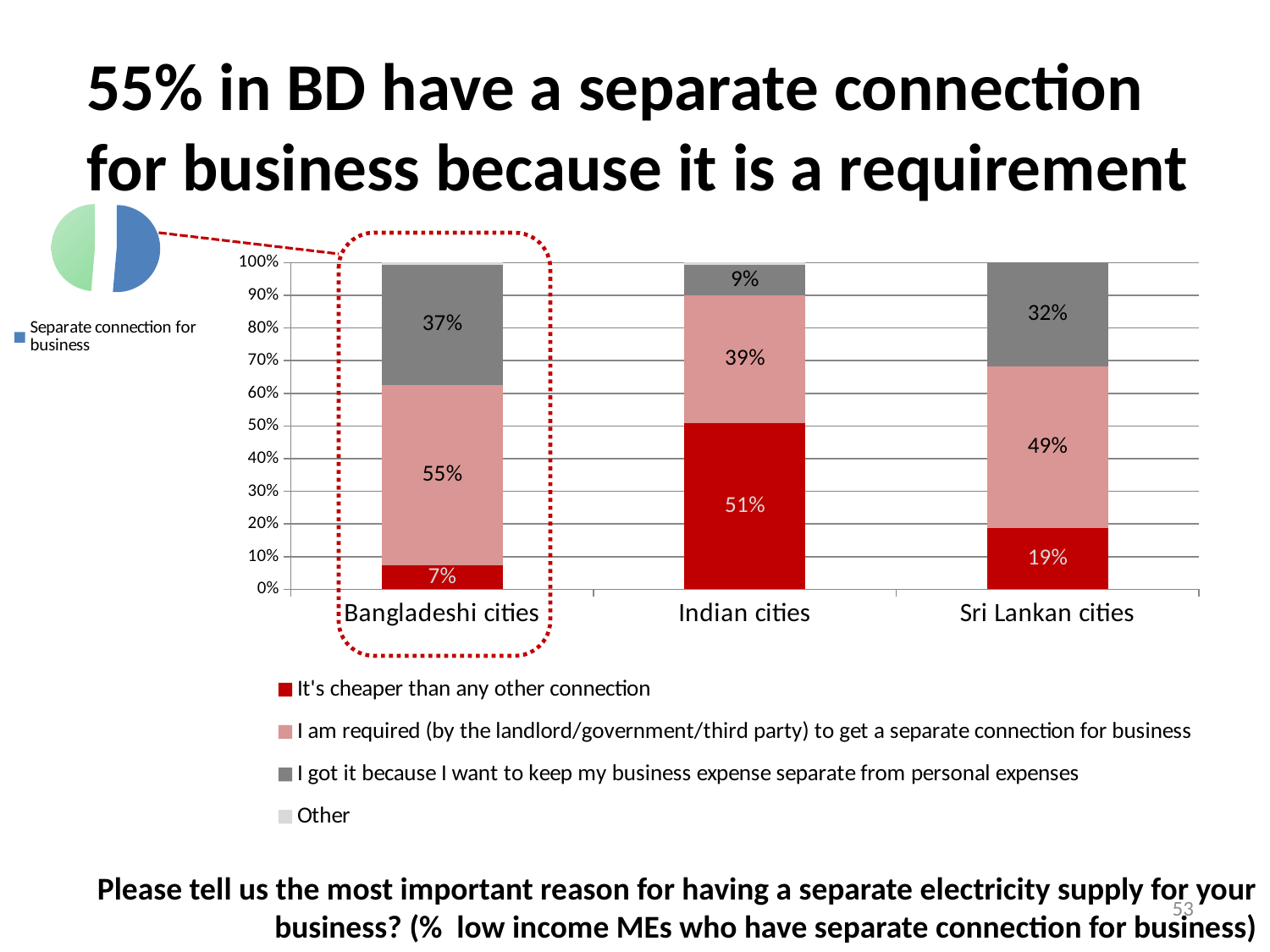
In the stacked bar chart, is the 'cheaper than any other connection' value larger in Sri Lankan cities or in Bangladeshi cities? Sri Lankan cities In the stacked bar chart, which colour represents 'It's cheaper than any other connection'? Red In the stacked bar chart, which city group has the lowest value for 'I got it because I want to keep my business expense separate from personal expenses'? Indian cities How many series does the legend of the stacked bar chart list? 4 In the stacked bar chart, what is the difference between the 'required' share in Bangladeshi cities and in Indian cities? 16 percentage points In the stacked bar chart, what is the value for 'It's cheaper than any other connection' in Indian cities? 51% How many city groups are shown on the x axis of the stacked bar chart? 3 In the stacked bar chart, what percentage of Bangladeshi cities respondents said they are required to get a separate connection for business? 55% In the stacked bar chart, is the 'required' value for Sri Lankan cities greater or less than 40%? greater In the stacked bar chart, which city group has the highest value for 'It's cheaper than any other connection'? Indian cities In the stacked bar chart, what share of Sri Lankan cities respondents got a separate connection to keep business expenses separate from personal expenses? 32% What kind of chart is the main chart on the slide? Stacked bar chart